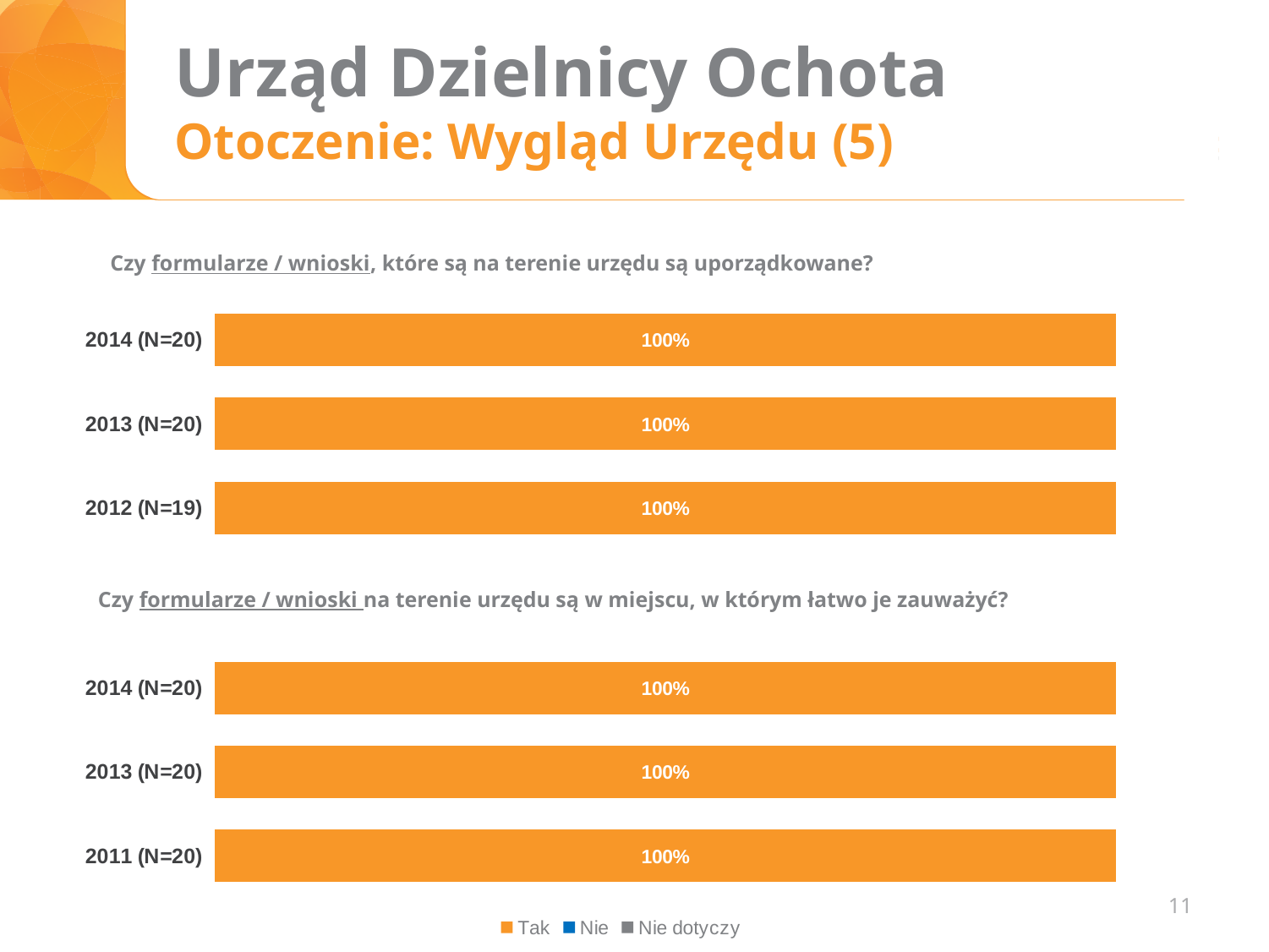
Which year label appears in the bottom chart but not in the top chart? 2011 (N=20) In the bottom chart, what is the value for 2013 (N=20)? 100% In the top chart, what is the value for 2012 (N=19)? 100% How many series does the legend at the bottom of the slide list? 3 How many categories are shown in the top chart? 3 Which legend entry corresponds to the orange bars? Tak In the top chart, what is the value for 2014 (N=20)? 100% In the bottom chart, do the values change across the years shown? No, they stay constant at 100% In the bottom chart, what is the value for 2011 (N=20)? 100% In the top chart, what is the difference between the values for 2014 (N=20) and 2012 (N=19)? 0% What kind of chart is the top chart? Bar chart How many categories are shown in the bottom chart? 3